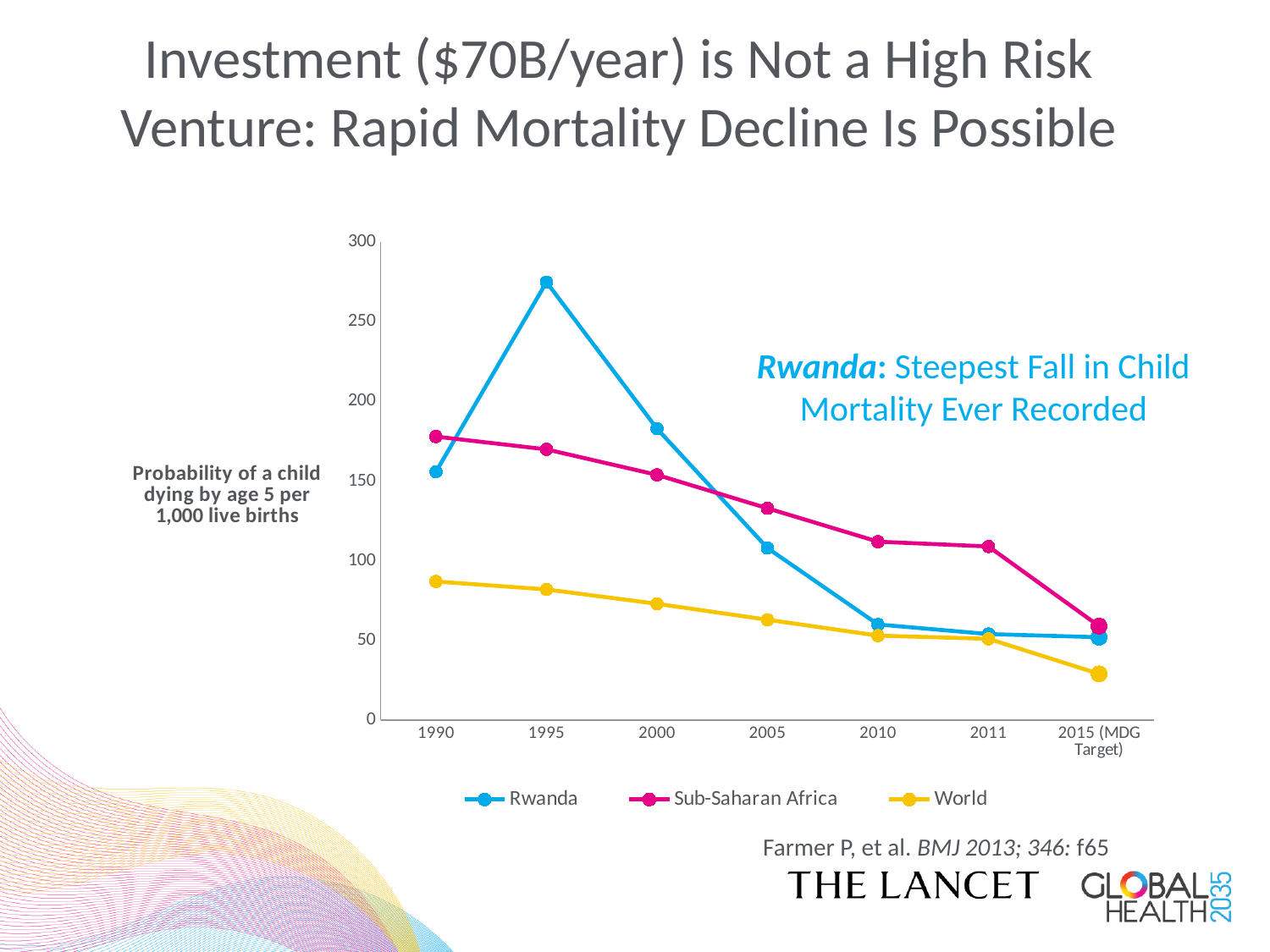
Does the World series rise or fall from 1990 to 2015 (MDG Target)? Fall Is the value for Rwanda in 2000 greater or less than 150? greater How many series does the legend list? 3 What is the label on the y axis of the chart? Probability of a child dying by age 5 per 1,000 live births Is the value for World in 1990 greater or less than 100? less What kind of chart is shown on the slide? Line chart In 2005, which is higher: Rwanda or Sub-Saharan Africa? Sub-Saharan Africa Is the value for Sub-Saharan Africa in 2015 (MDG Target) greater or less than 100? less In 1990, which is higher: Rwanda or Sub-Saharan Africa? Sub-Saharan Africa How many points are shown along the x axis? 7 In which year does the Rwanda series reach its highest value? 1995